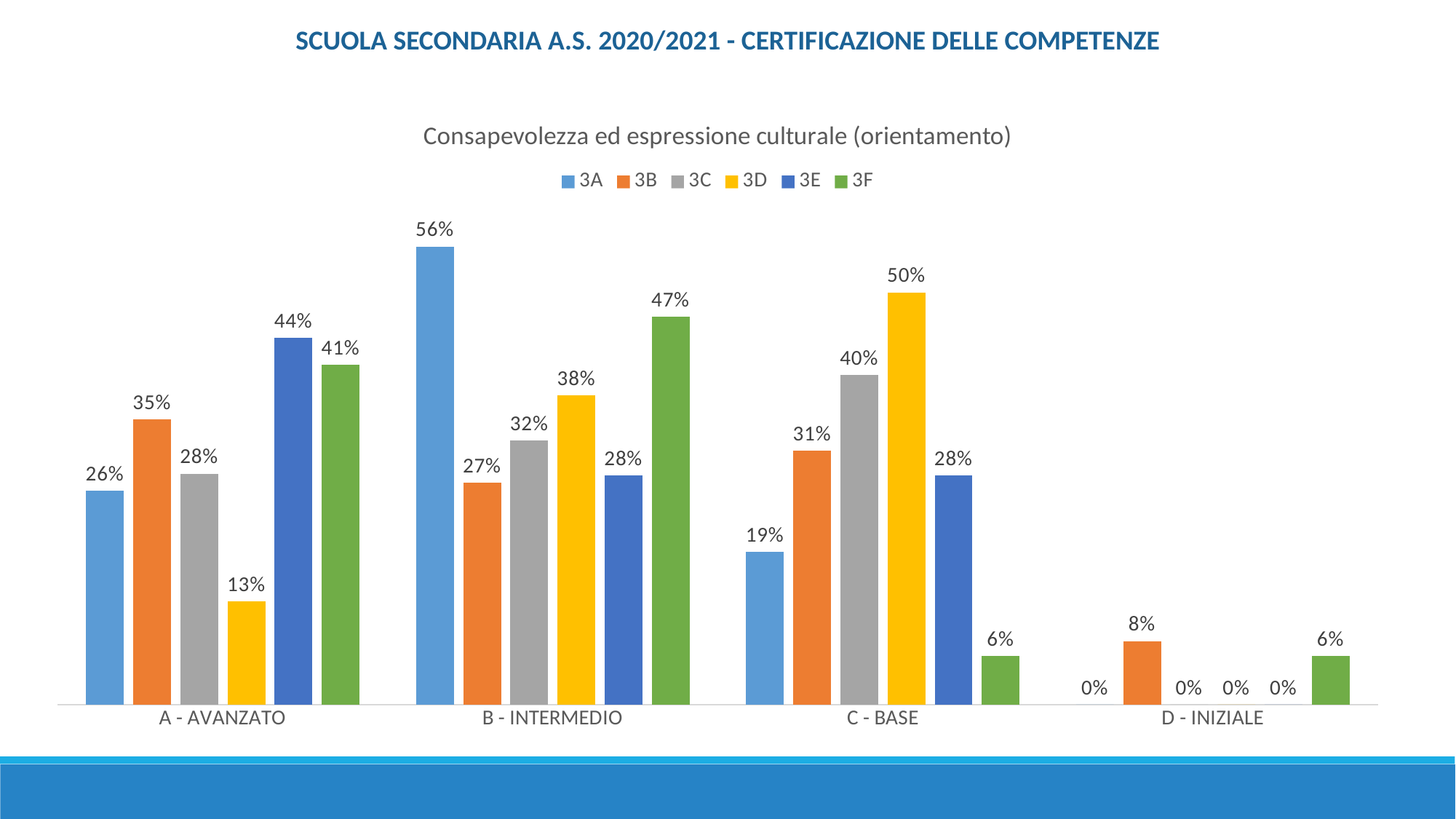
How many categories are shown on the x axis? 4 What kind of chart is shown on the slide? Bar chart Which series has the lowest value in the A - AVANZATO category? 3D What is the value for 3A in the B - INTERMEDIO category? 56% What is the title of the chart? Consapevolezza ed espressione culturale (orientamento) Which series has the highest value in the C - BASE category? 3D What is the value for 3F in the C - BASE category? 6% How many series does the legend list? 6 What is the difference between the 3A and 3B values in the B - INTERMEDIO category? 29% Which is larger in the A - AVANZATO category: the value for 3E or the value for 3F? 3E What is the value for 3D in the A - AVANZATO category? 13% Which series has a value of 8% in the D - INIZIALE category? 3B